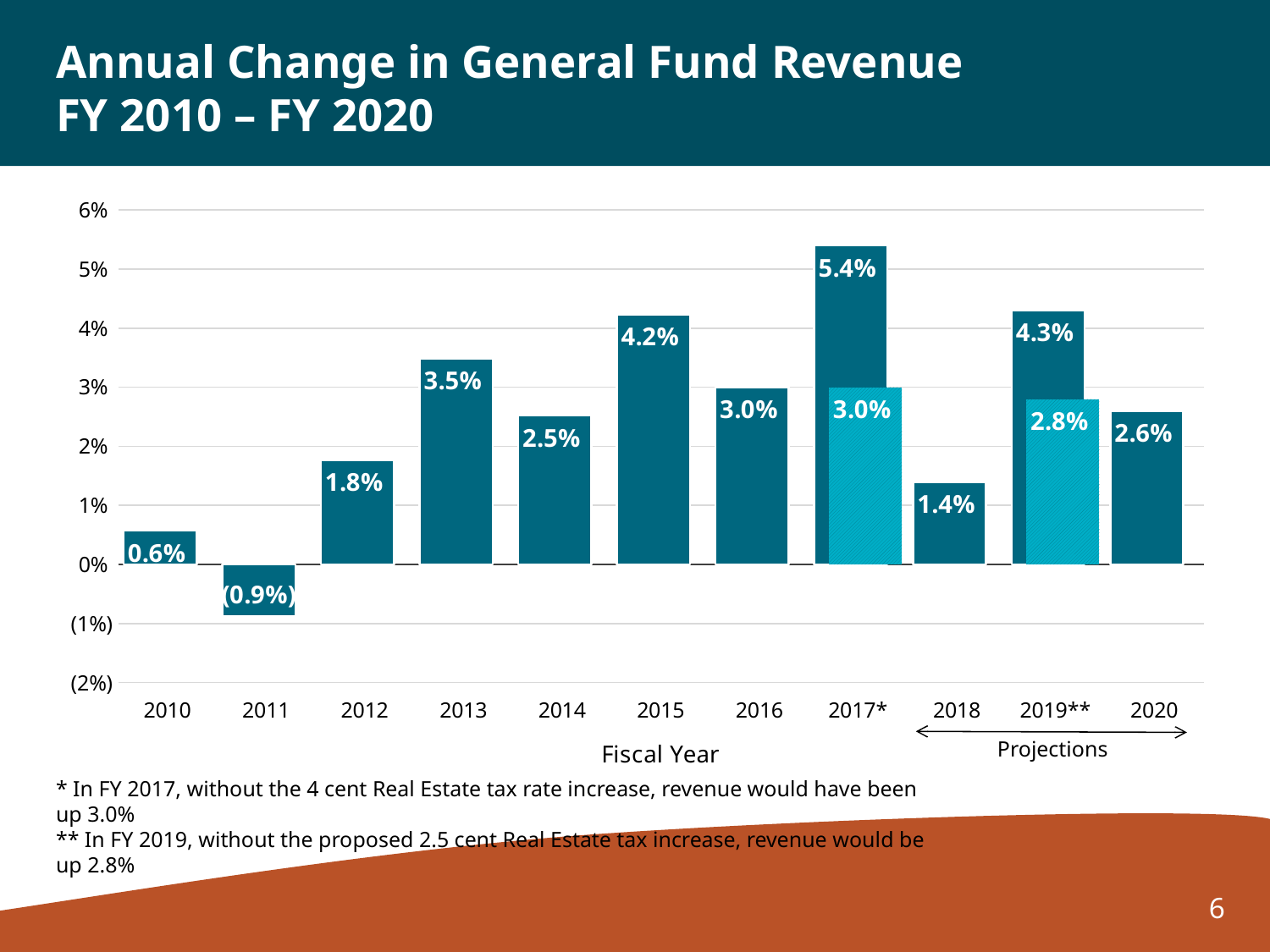
Which fiscal years are marked as projections on the chart? 2018, 2019**, 2020 What is the projected annual change in General Fund revenue for FY 2020? 2.6% Which fiscal year has the lowest annual change in General Fund revenue? 2011 What kind of chart is shown on the slide? Bar chart What is the annual change in General Fund revenue for FY 2011? (0.9%) What is the annual change in General Fund revenue for FY 2013? 3.5% What is the difference between the annual change for FY 2015 and FY 2014? 1.7% Which fiscal year has the highest annual change in General Fund revenue? 2017* Which fiscal year has a larger annual change in General Fund revenue, 2012 or 2018? 2012 According to the chart, what would the FY 2017 revenue change have been without the 4 cent Real Estate tax rate increase? 3.0% How many fiscal years are shown on the x axis of the chart? 11 What is the label on the x axis of the chart? Fiscal Year